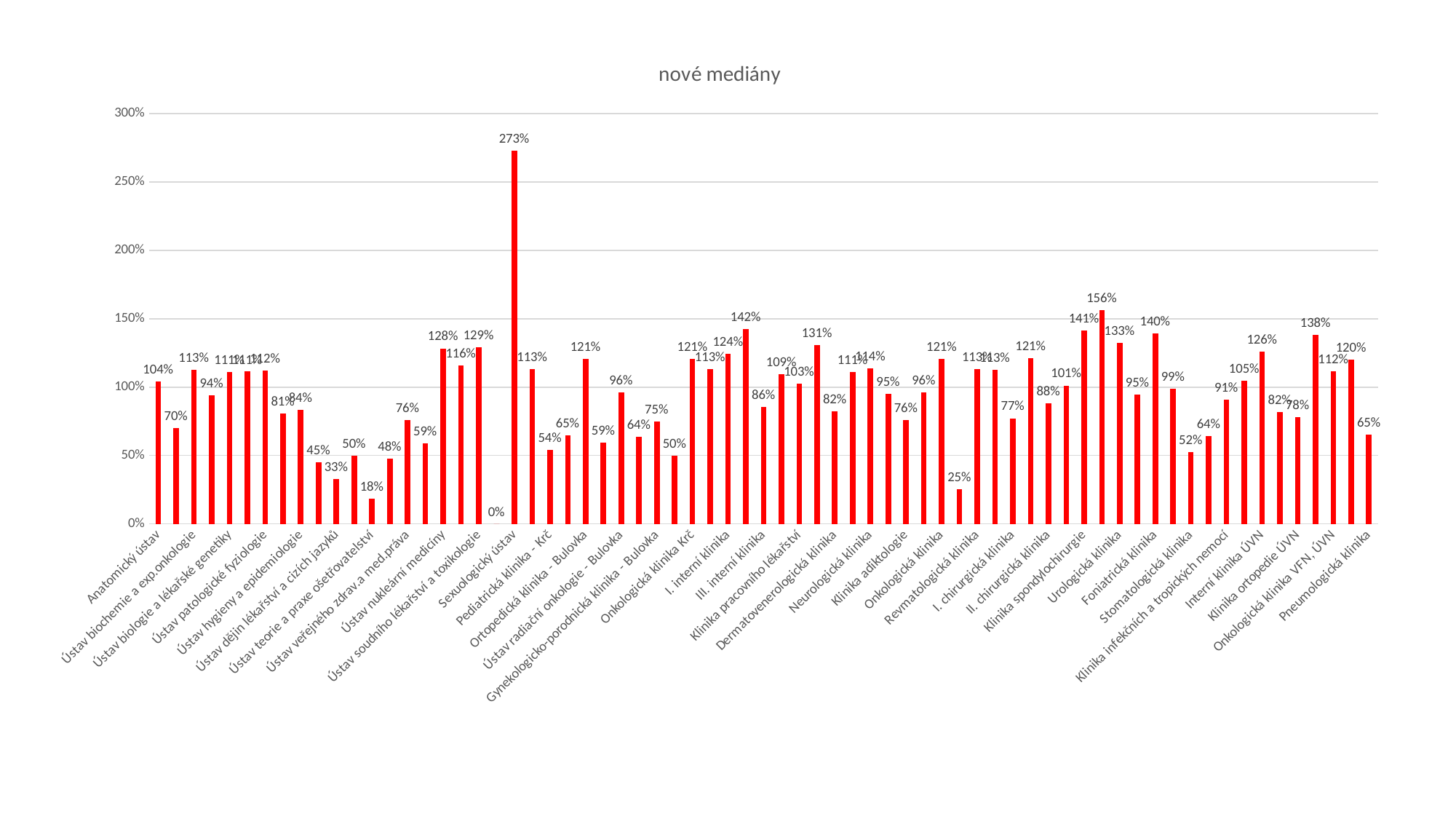
Which category has the highest value in the chart? Sexuologický ústav Which is larger, the value for Sexuologický ústav or the value for Anatomický ústav? Sexuologický ústav What is the difference between the value for Sexuologický ústav and the value for Anatomický ústav? 169% What is the value for Klinika spondylochirurgie? 141% What is the value for Sexuologický ústav? 273% What is the value for Anatomický ústav? 104% What is the value for Foniatrická klinika? 140% What is the lowest value shown in the chart? 0% What is the title of the chart? nové mediány What kind of chart is shown on the slide? bar chart What is the value for Pneumologická klinika? 65% Is the value for Sexuologický ústav greater or less than 250%? greater